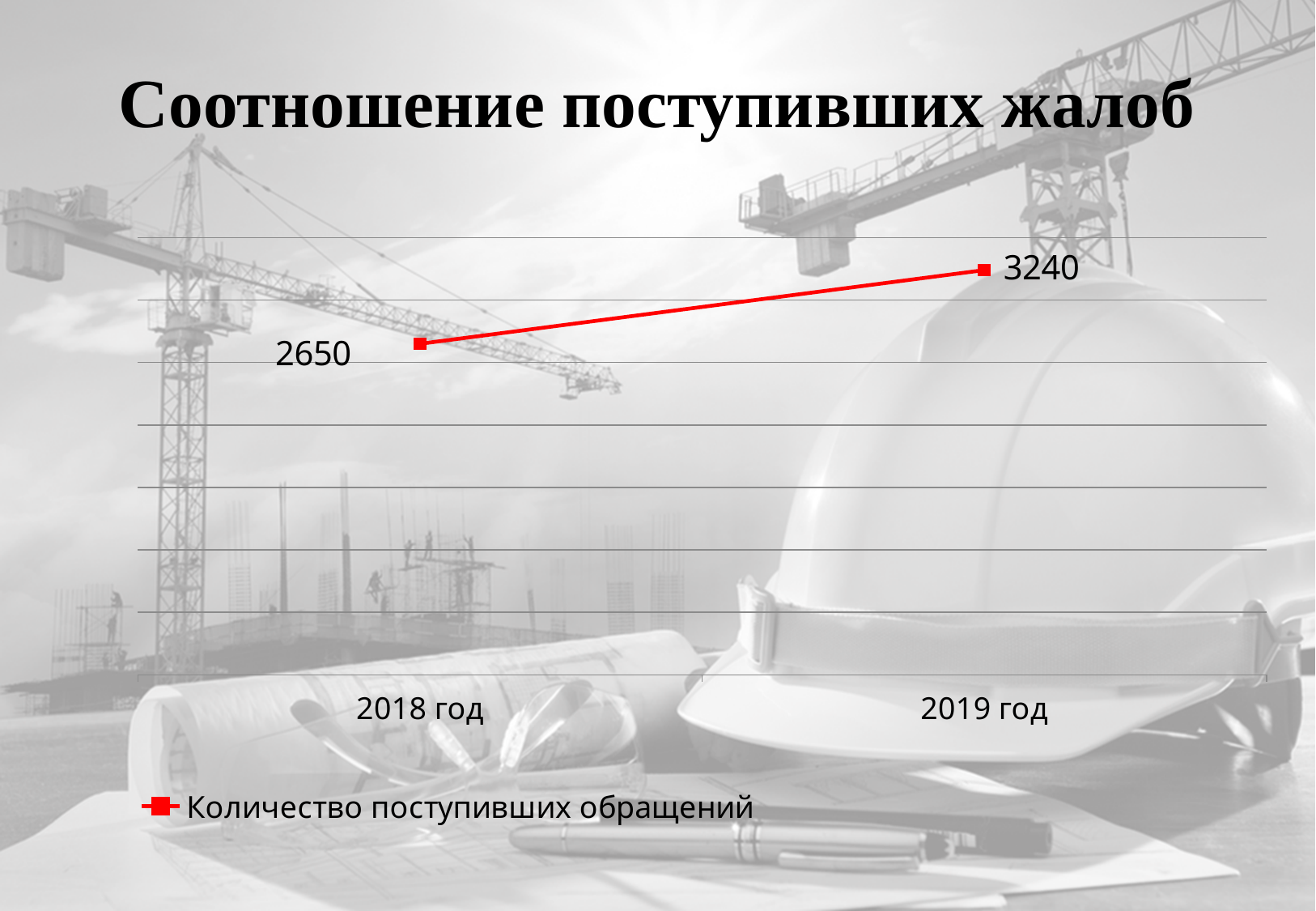
What is the value for 2019 год? 3240 Do the values rise or fall from 2018 год to 2019 год? rise What is the name of the series in the legend? Количество поступивших обращений Which year has the highest value? 2019 год How many series does the legend list? 1 How many data points are plotted on the chart? 2 What is the title of the chart? Соотношение поступивших жалоб What is the difference between the values for 2019 год and 2018 год? 590 What is the value for 2018 год? 2650 Which is larger, the value for 2018 год or 2019 год? 2019 год Which year has the lowest value? 2018 год What kind of chart is shown on the slide? line chart